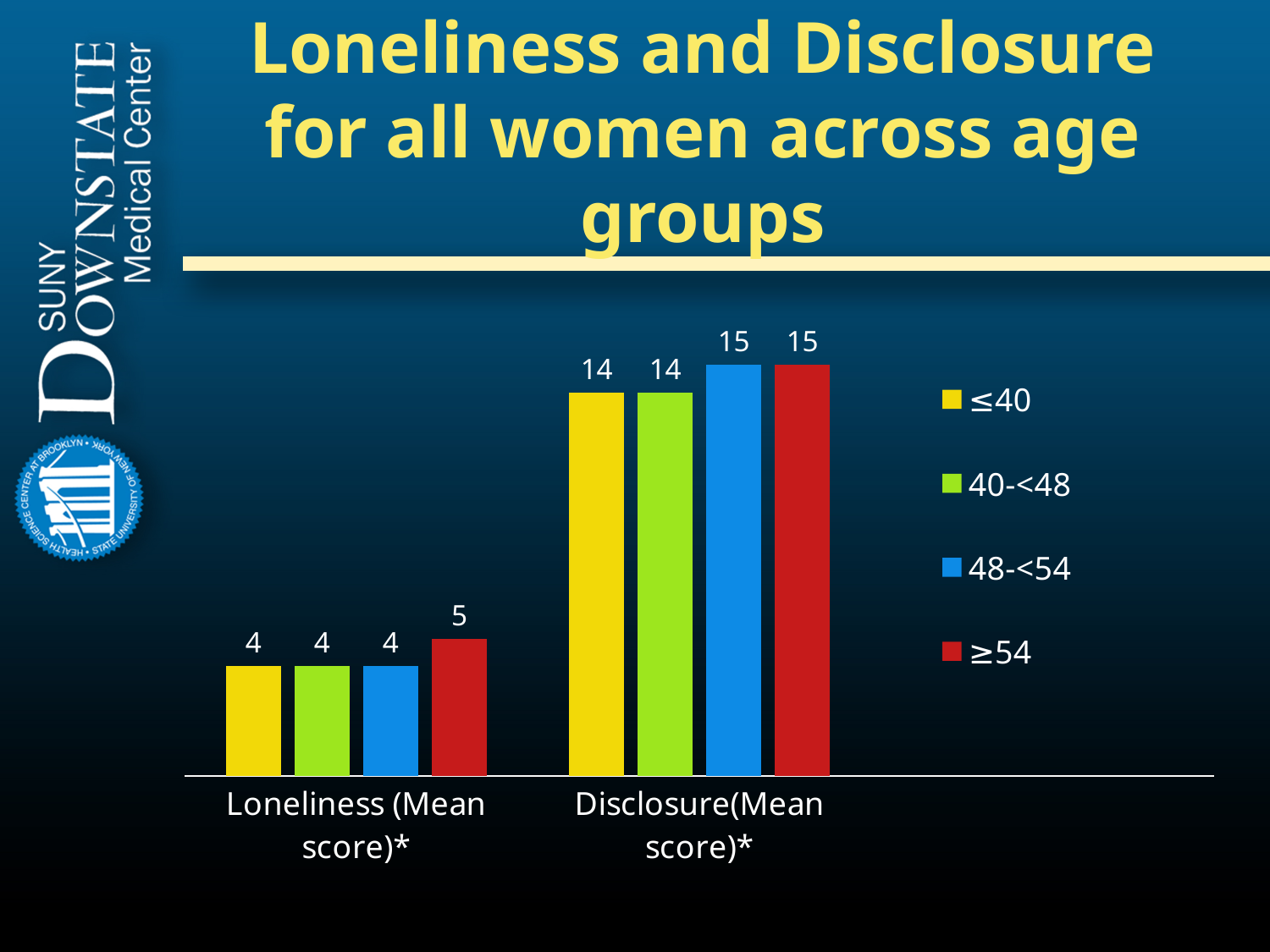
How many categories are shown on the x axis? 2 What is the Disclosure (Mean score) value for the 48-<54 age group? 15 Which age group has the highest Loneliness (Mean score)? ≥54 What is the difference between the Disclosure (Mean score) and the Loneliness (Mean score) for the 48-<54 age group? 11 What is the Loneliness (Mean score) value for the 40-<48 age group? 4 What kind of chart is shown on the slide? Bar chart What is the Disclosure (Mean score) value for the ≤40 age group? 14 Which colour represents the 40-<48 age group in the legend? Green What is the Loneliness (Mean score) value for the ≥54 age group? 5 Which is larger: the Loneliness (Mean score) for ≥54 or for ≤40? ≥54 What is the difference between the Disclosure (Mean score) for ≥54 and for ≤40? 1 How many age-group series does the legend list? 4